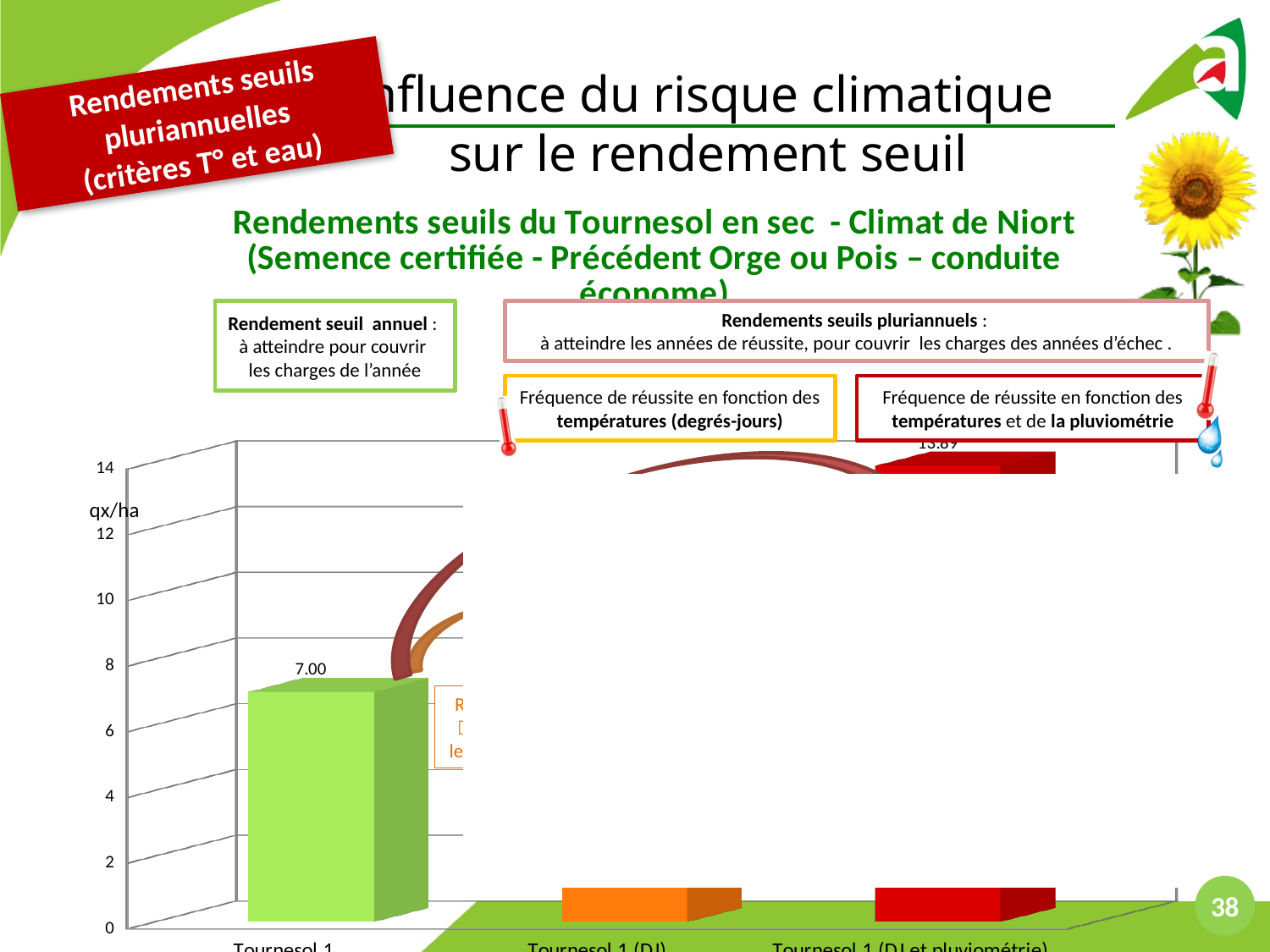
What kind of chart is shown on the slide? bar chart What unit is shown on the vertical axis of the chart? qx/ha How many categories are shown on the x axis of the chart? 3 Which is larger, the value for Tournesol 1 or the value for Tournesol 1 (DJ et pluviométrie)? Tournesol 1 (DJ et pluviométrie) Is the value for Tournesol 1 greater or less than 6? greater What colour is the bar for Tournesol 1? green What is the value for Tournesol 1? 7.00 Is the value for Tournesol 1 greater or less than 8? less Is the value for Tournesol 1 (DJ et pluviométrie) greater or less than 12? greater